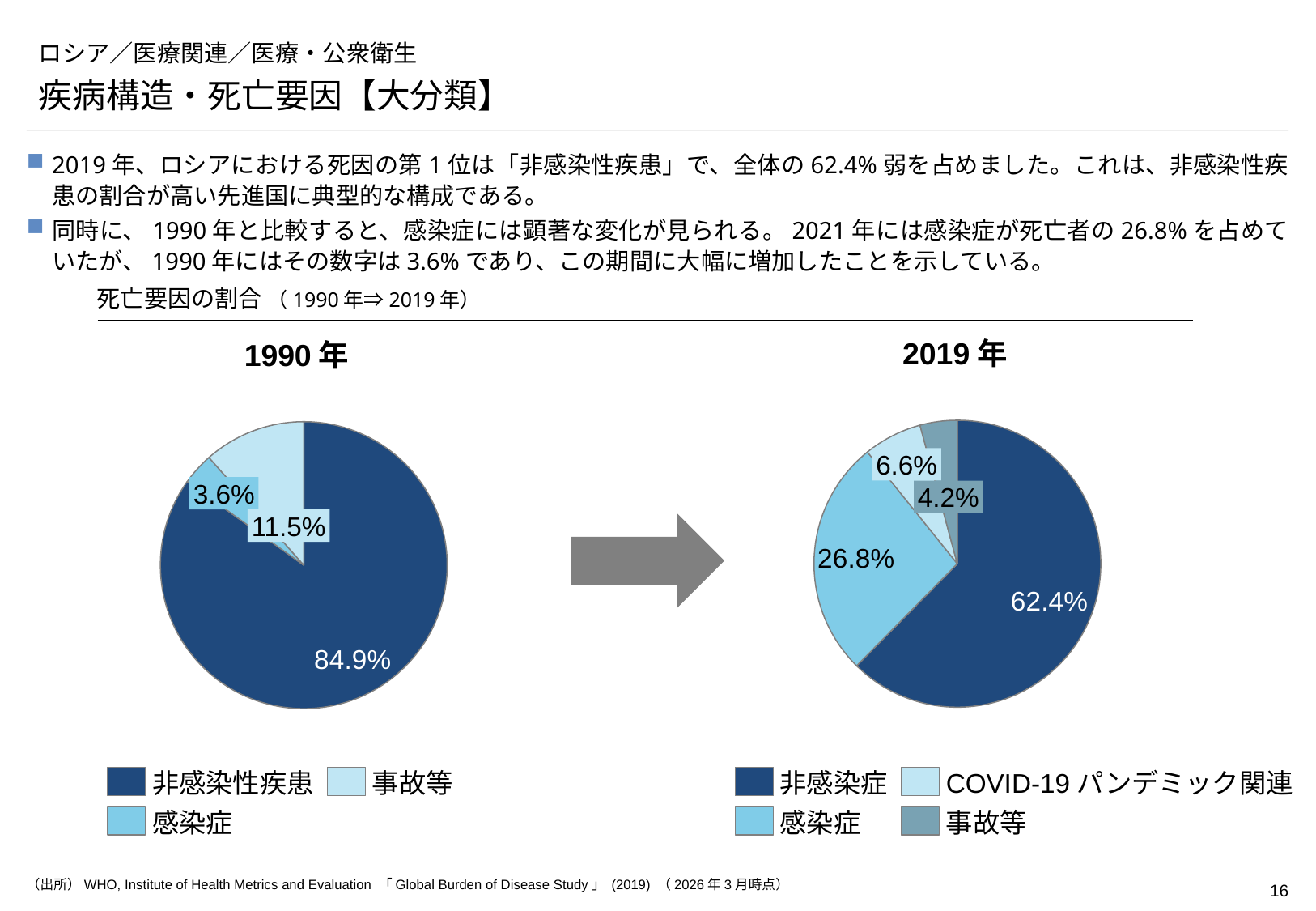
In the 2019年 pie chart, what share is labelled for COVID-19 パンデミック関連? 6.6% In the 1990年 pie chart, what share is labelled for 非感染性疾患? 84.9% How many categories does the legend of the 2019年 pie chart list? 4 In the 2019年 pie chart, which category has the largest share? 非感染症 In the 2019年 pie chart, what share is labelled for 感染症? 26.8% In the 1990年 pie chart, what share is labelled for 事故等? 11.5% In the 2019年 pie chart, what share is labelled for 事故等? 4.2% In the 1990年 pie chart, which category has the smallest share? 感染症 What type of chart is used for the 1990年 data? Pie chart In the 1990年 pie chart, what share is labelled for 感染症? 3.6% What is the difference between the 感染症 share in the 2019年 pie chart and the 感染症 share in the 1990年 pie chart? 23.2% In the 2019年 pie chart, which is larger: the share for COVID-19 パンデミック関連 or the share for 事故等? COVID-19 パンデミック関連